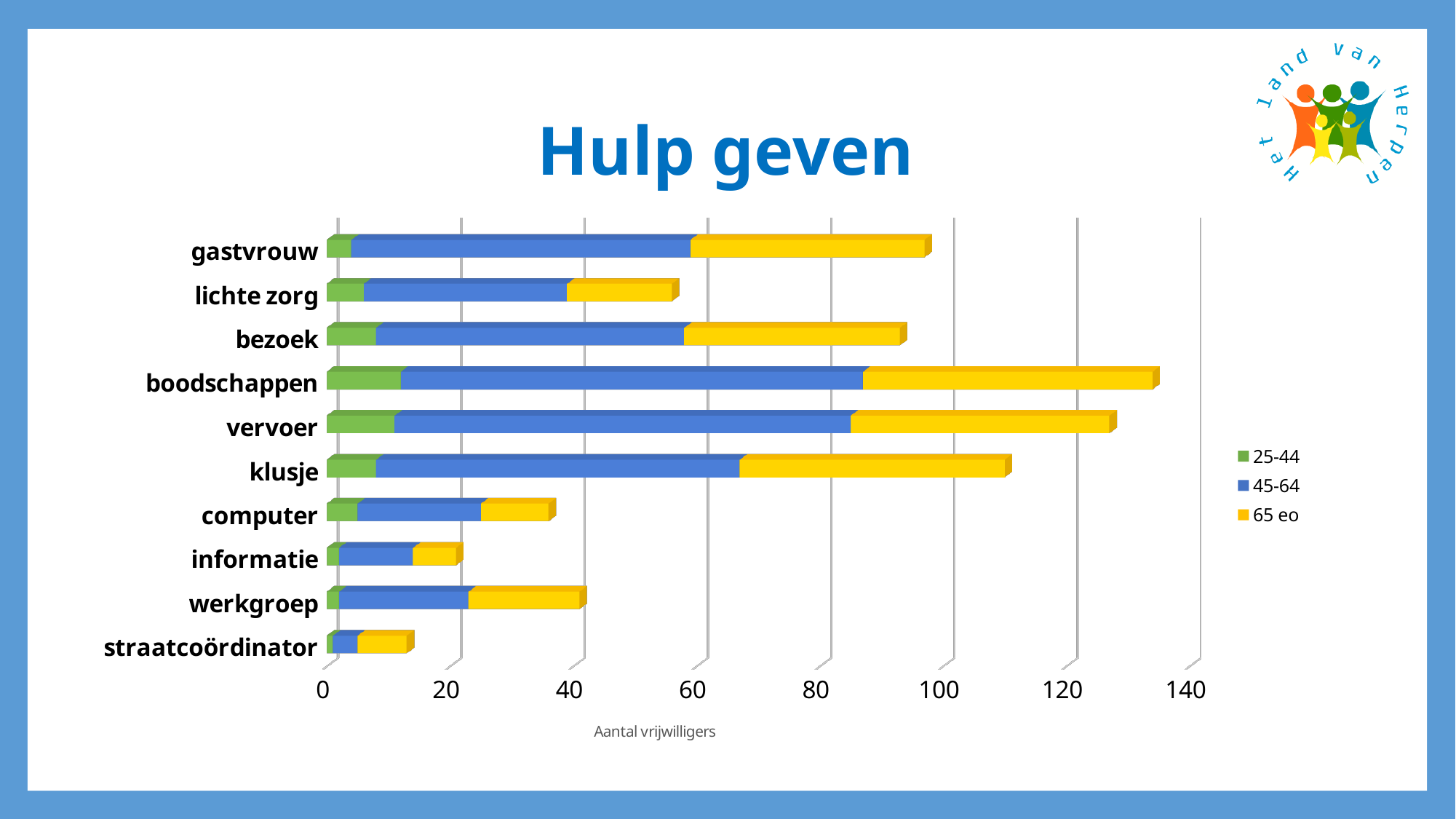
Is the total value for klusje greater or less than 100? greater What is the label on the horizontal axis? Aantal vrijwilligers Is the total value for lichte zorg greater or less than 60? less What kind of chart is shown on the slide? bar chart What is the title of the chart? Hulp geven Is the total value for straatcoördinator greater or less than 20? less How many series does the legend list? 3 Which category has the longest total bar? boodschappen How many categories are shown on the chart? 10 Which category has the shortest total bar? straatcoördinator Which has the larger total bar, klusje or bezoek? klusje